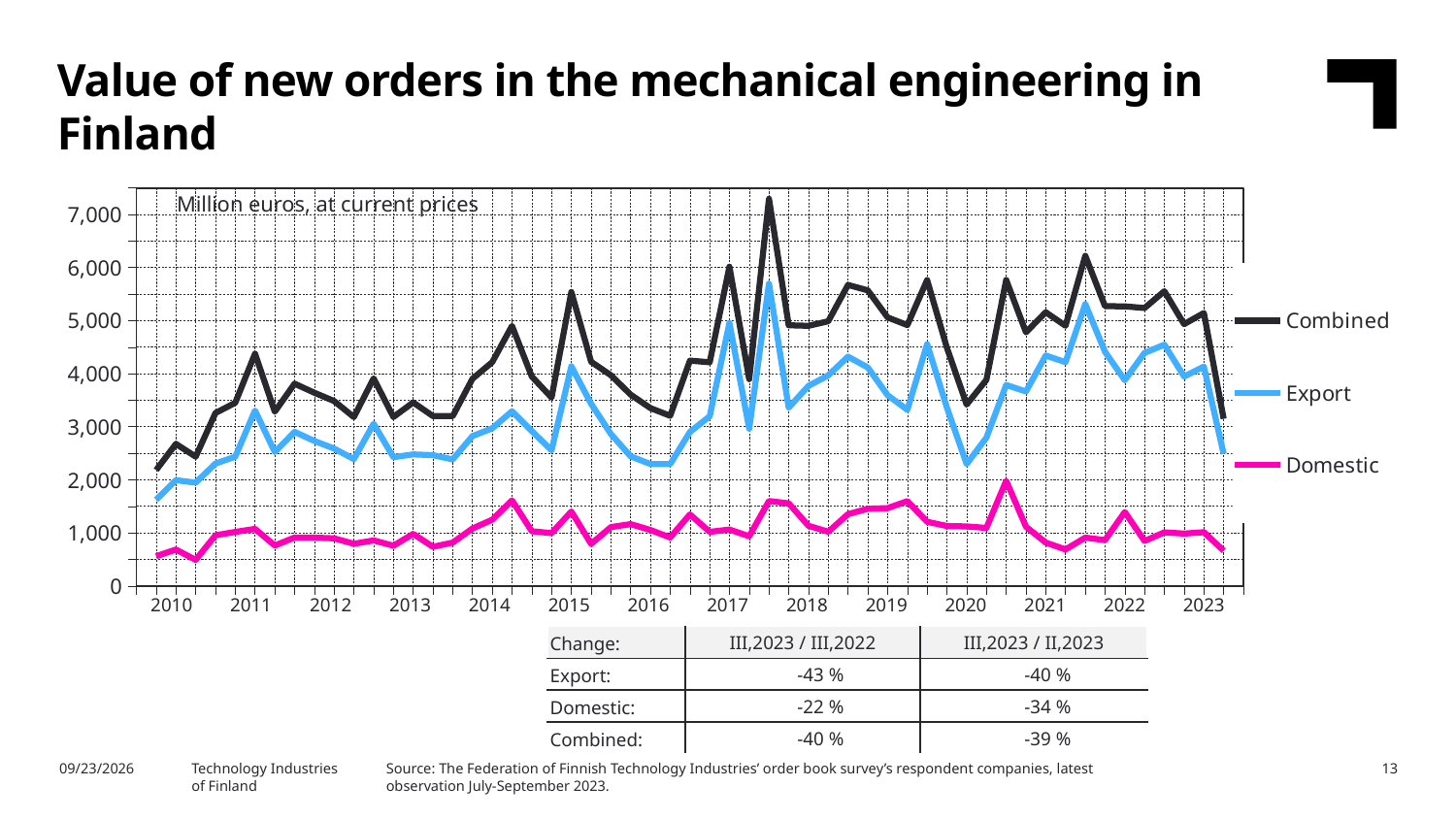
Which series is larger in 2019, Export or Domestic? Export What are the three series named in the legend? Combined, Export, Domestic Which series has the highest values throughout the chart? Combined Is the value of the Combined series at the start of 2010 greater or less than 2,000? greater Is the value of the Domestic series at the start of 2010 greater or less than 1,000? less Is the last plotted value of the Export series in 2023 greater or less than 3,000? less What kind of chart is shown on the slide? Line chart What unit is stated for the values in the chart? Million euros, at current prices Which series has the lowest values throughout the chart? Domestic How many series does the legend list? 3 How many year labels are shown on the x axis? 14